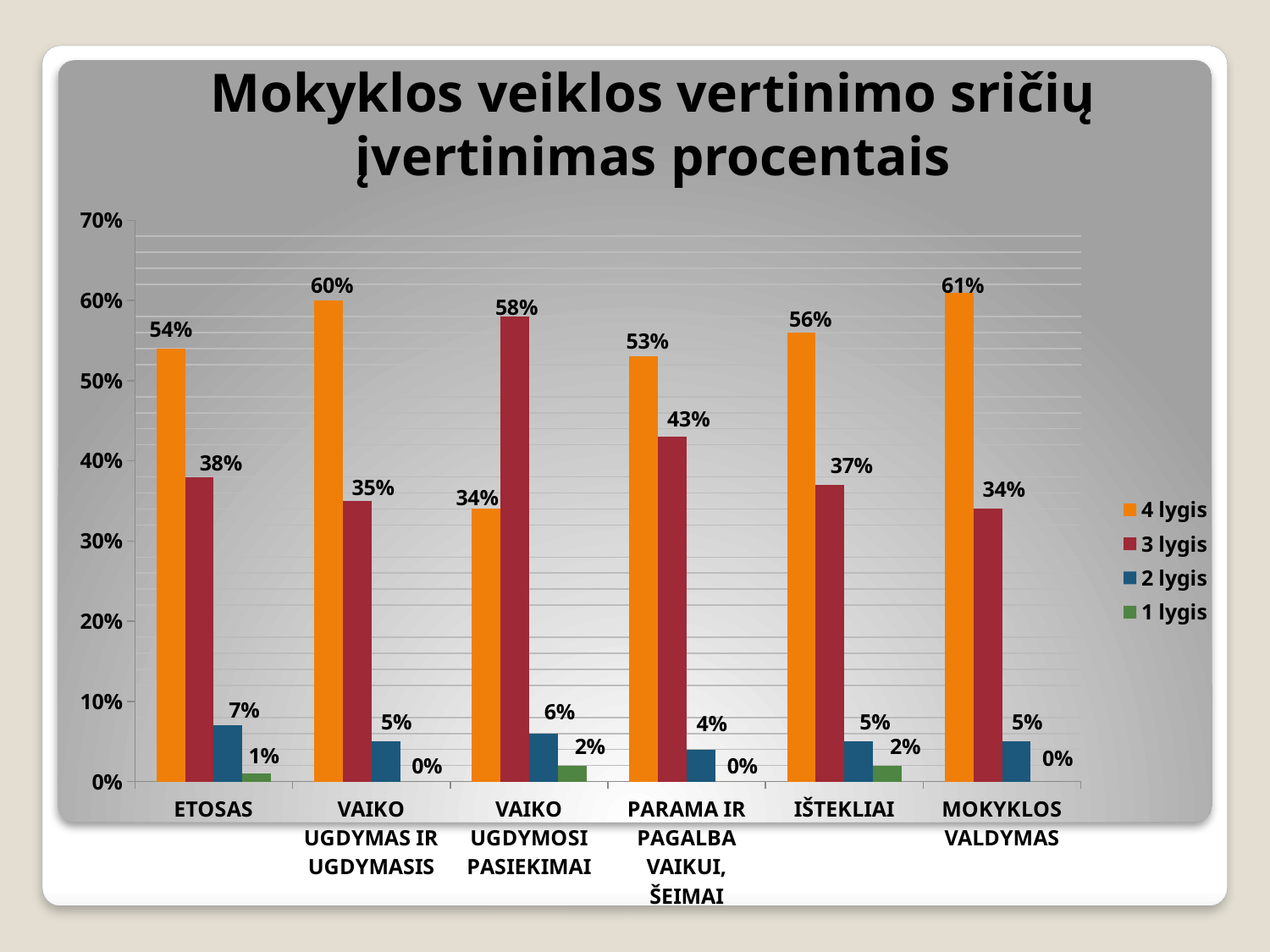
How many categories are shown on the x axis? 6 Which category has the lowest value in the 4 lygis series? VAIKO UGDYMOSI PASIEKIMAI What is the value of the 4 lygis series for ETOSAS? 54% How many series does the legend list? 4 What is the title of the chart? Mokyklos veiklos vertinimo sričių įvertinimas procentais Is the 3 lygis value for PARAMA IR PAGALBA VAIKUI, ŠEIMAI greater or less than 40%? greater What is the value of the 2 lygis series for PARAMA IR PAGALBA VAIKUI, ŠEIMAI? 4% Which is larger for VAIKO UGDYMOSI PASIEKIMAI: the 4 lygis value or the 3 lygis value? 3 lygis What is the value of the 3 lygis series for VAIKO UGDYMOSI PASIEKIMAI? 58% What is the difference between the 4 lygis and 3 lygis values for IŠTEKLIAI? 19% What kind of chart is shown on the slide? bar chart Which category has the highest value in the 4 lygis series? MOKYKLOS VALDYMAS